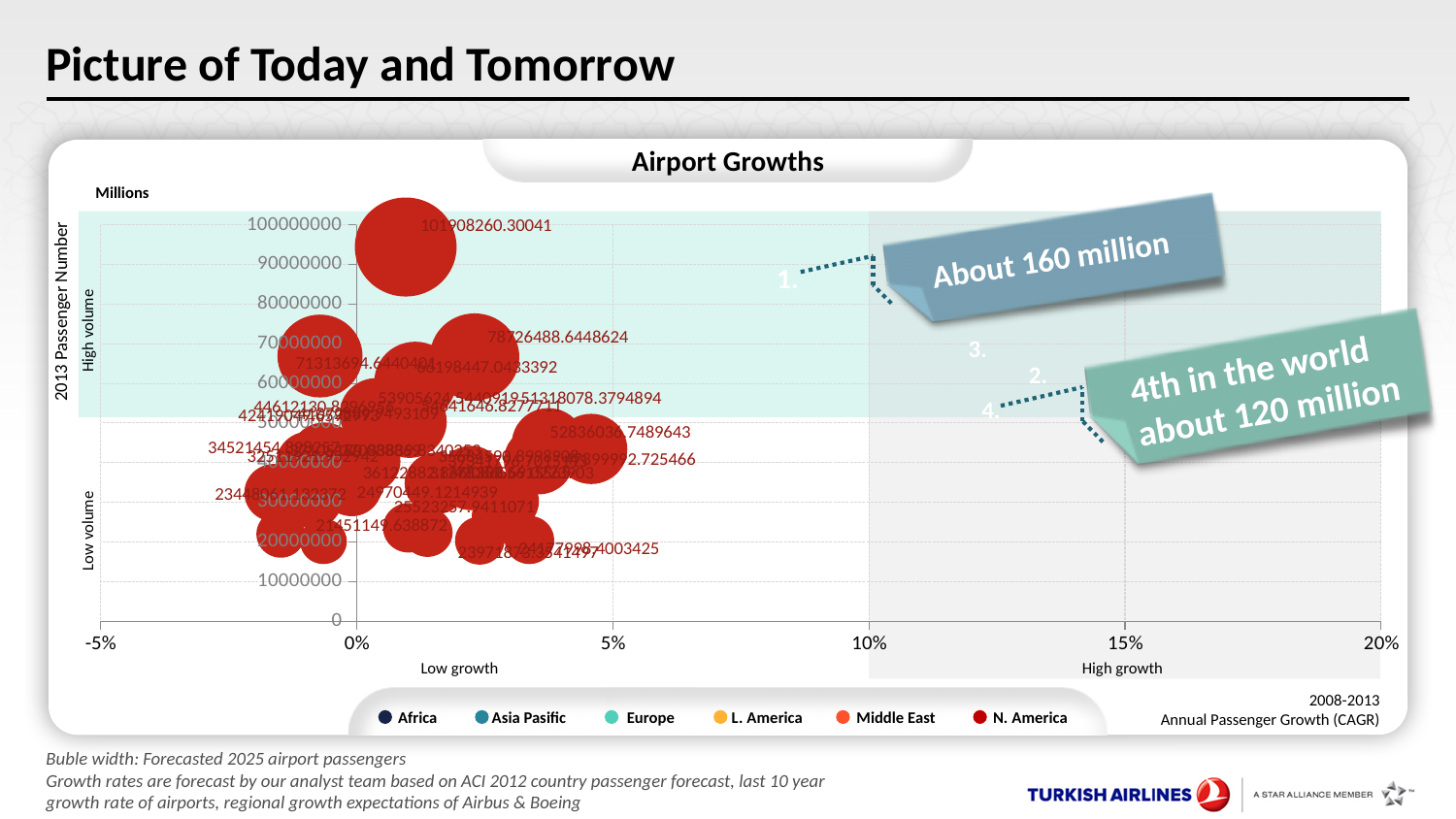
Are the annual passenger growth rates of all plotted bubbles greater or less than 10%? less What is the lowest value shown on the x axis of the chart? -5% Is the 2013 passenger number of the highest bubble greater or less than 90000000? greater Is the 2013 passenger number of the lowest bubble greater or less than 30000000? less How many series does the legend of the Airport Growths chart list? 6 What kind of chart is shown on the slide? Bubble chart Which region of the x axis, low growth or high growth, contains the plotted bubbles? Low growth Which legend series is shown in red? N. America What is the highest value shown on the x axis of the chart? 20% What is the title of the chart? Airport Growths What is the highest tick value shown on the y axis of the chart? 100000000